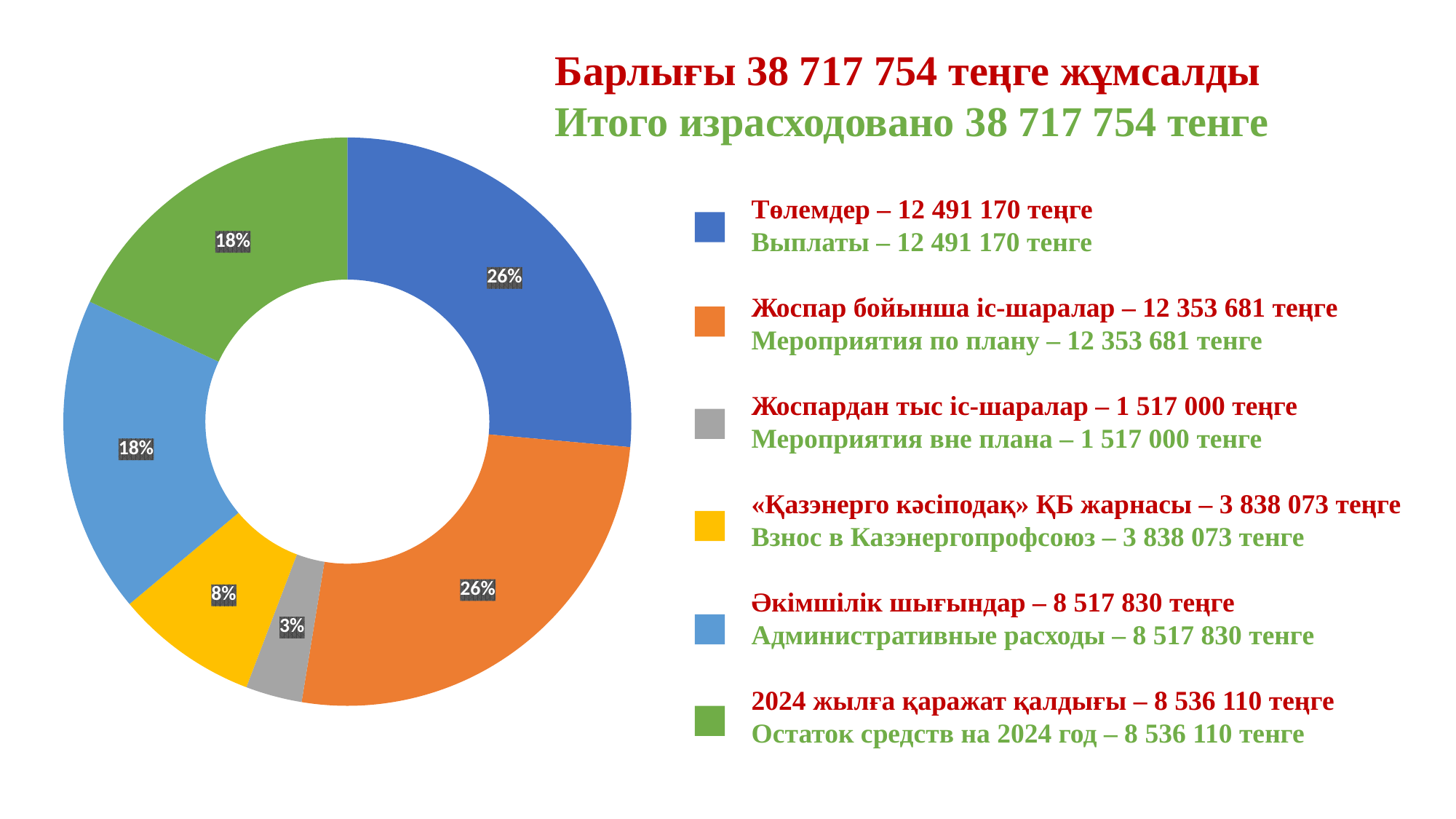
What is the difference in percentage points between the Остаток средств на 2024 год slice and the Взнос в Казэнергопрофсоюз slice? 10% What share of the chart is labelled for Мероприятия вне плана (grey slice)? 3% Which category has the smallest slice in the chart? Мероприятия вне плана How many slices does the chart have? 6 According to the legend, what amount is given for Административные расходы? 8 517 830 тенге What share of the chart is labelled for Административные расходы (light blue slice)? 18% What share of the chart is labelled for Взнос в Казэнергопрофсоюз (yellow slice)? 8% What colour represents Остаток средств на 2024 год in the chart? green According to the legend, what amount is given for Выплаты? 12 491 170 тенге Which slice is larger: Взнос в Казэнергопрофсоюз or Мероприятия вне плана? Взнос в Казэнергопрофсоюз What kind of chart is shown on the slide? doughnut (pie) chart What total amount spent is stated in the slide title? 38 717 754 тенге